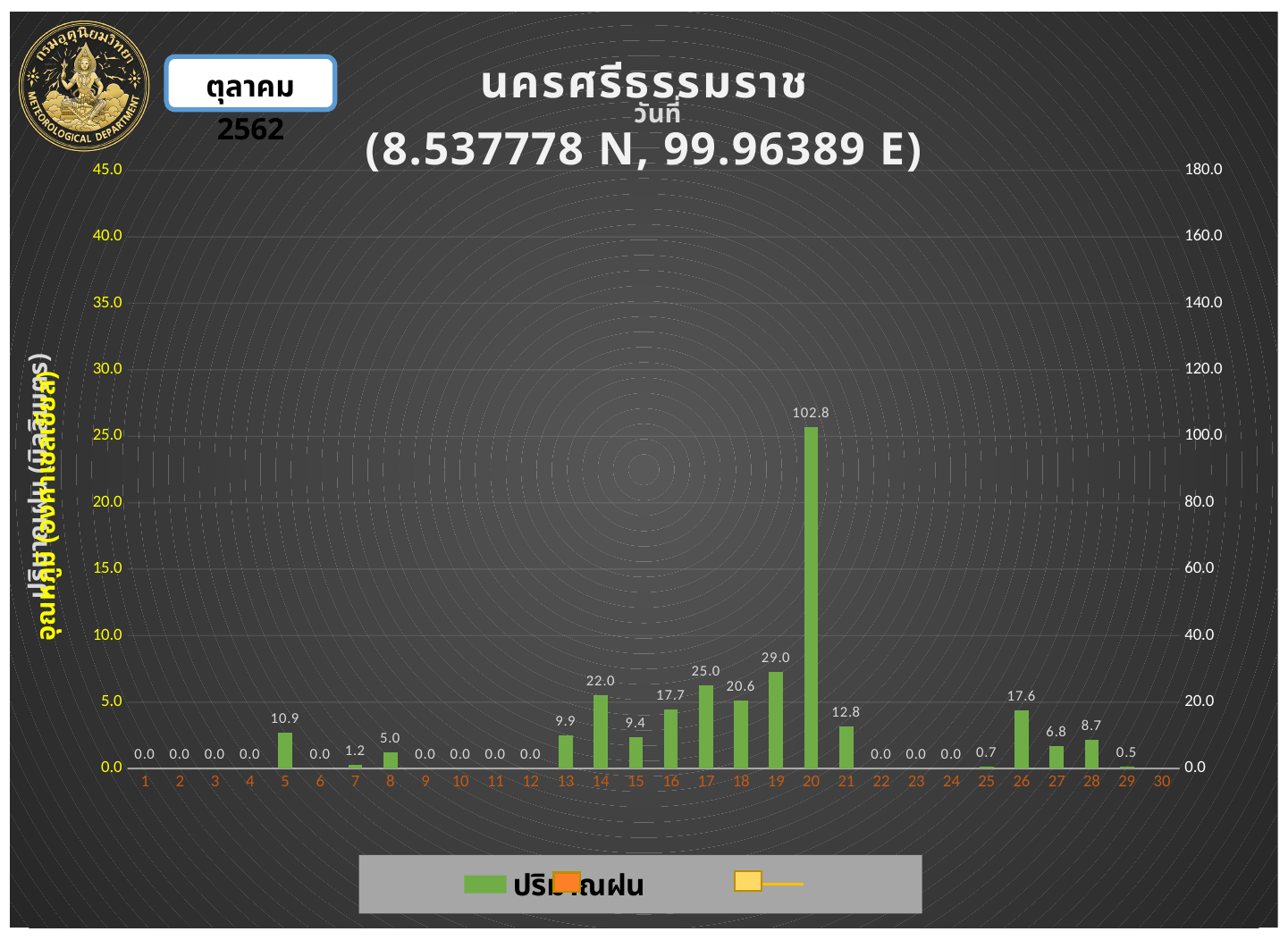
Which day has the highest rainfall value? 20 What is the difference between the rainfall values on day 19 and day 17? 4.0 Which is larger, the rainfall value on day 13 or on day 15? day 13 What is the difference between the rainfall values on day 20 and day 21? 90.0 What is the highest tick value on the right-hand axis? 180.0 What is the rainfall value on day 26? 17.6 How many days are shown on the x axis? 30 What kind of chart is shown on the slide? bar chart What is the rainfall value on day 20? 102.8 What is the rainfall value on day 14? 22.0 What is the rainfall value on day 5? 10.9 Which is larger, the rainfall value on day 16 or on day 18? day 18